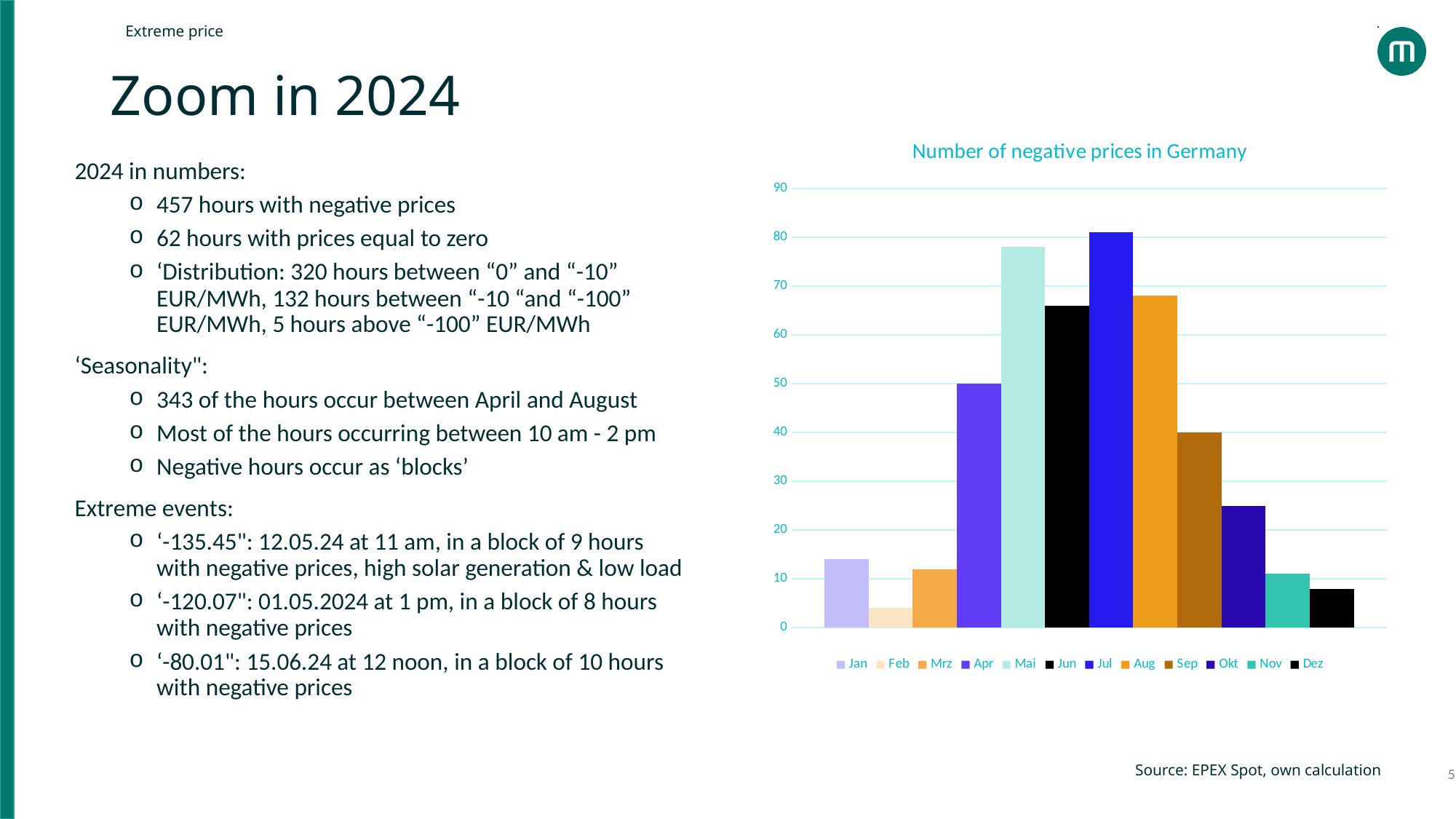
Is the value for Okt greater or less than 20? greater Which month has the highest number of negative prices? Jul How many entries does the chart legend list? 12 Do the values rise or fall from Jul to Dez? fall Is the value for Jan greater or less than 20? less How many months (bars) are shown in the chart? 12 Is the value for Mai greater or less than 70? greater Which is larger, the value for Jun or the value for Sep? Jun What type of chart is shown on the slide? bar chart Which month has the lowest number of negative prices? Feb What is the title of the chart? Number of negative prices in Germany